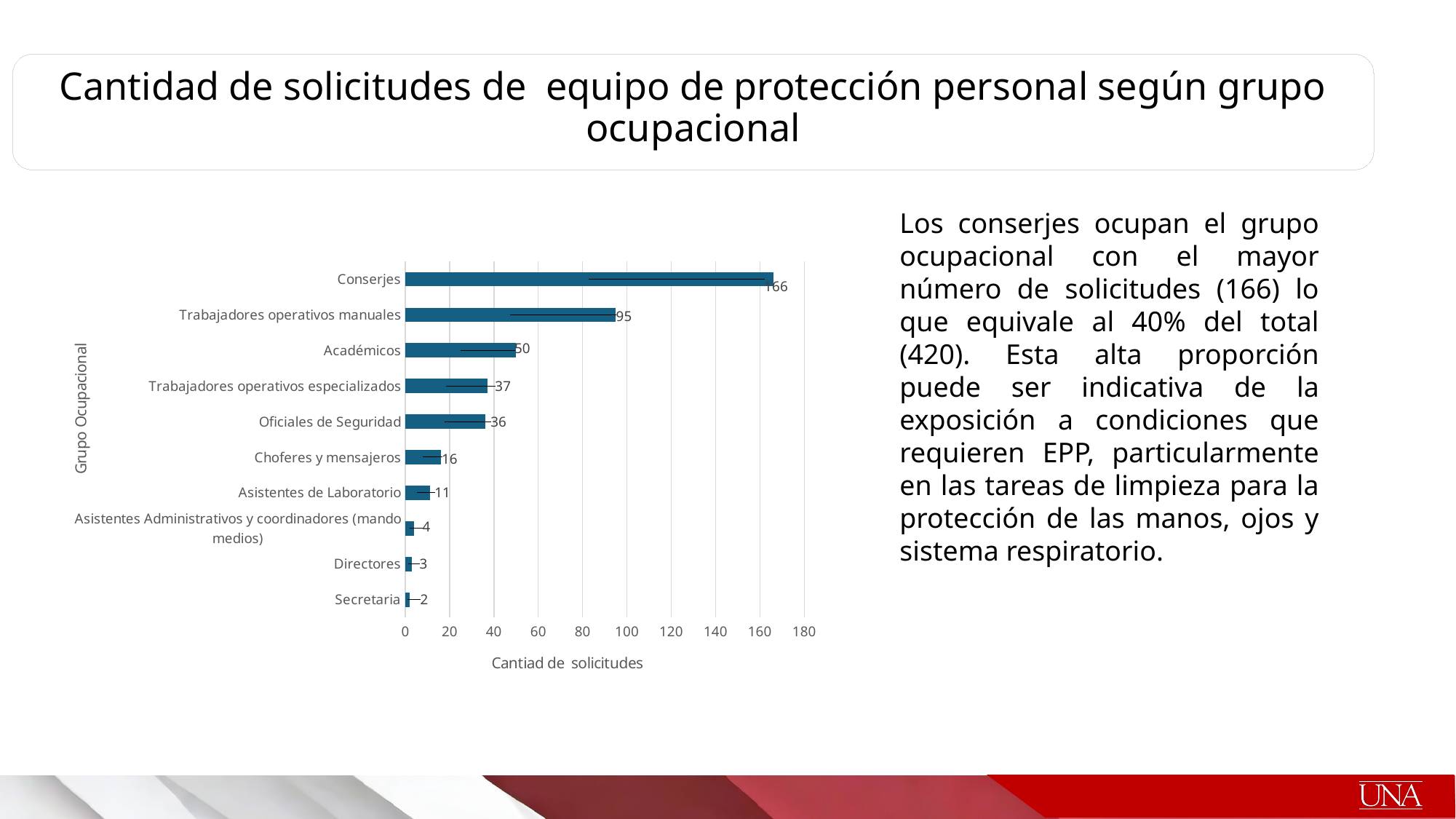
What is the difference between the values for Conserjes and Trabajadores operativos manuales? 71 Is the value for Conserjes greater or less than 160? greater What is the label of the horizontal axis of the chart? Cantiad de solicitudes What kind of chart is shown on the slide? Bar chart What is the value for Oficiales de Seguridad? 36 Which occupational group has the lowest number of requests? Secretaria Which occupational group has the highest number of requests? Conserjes What is the value for Trabajadores operativos manuales? 95 Which is larger, the value for Académicos or the value for Trabajadores operativos especializados? Académicos How many requests are shown for Conserjes? 166 How many occupational groups are shown in the chart? 10 What is the value for Asistentes de Laboratorio? 11